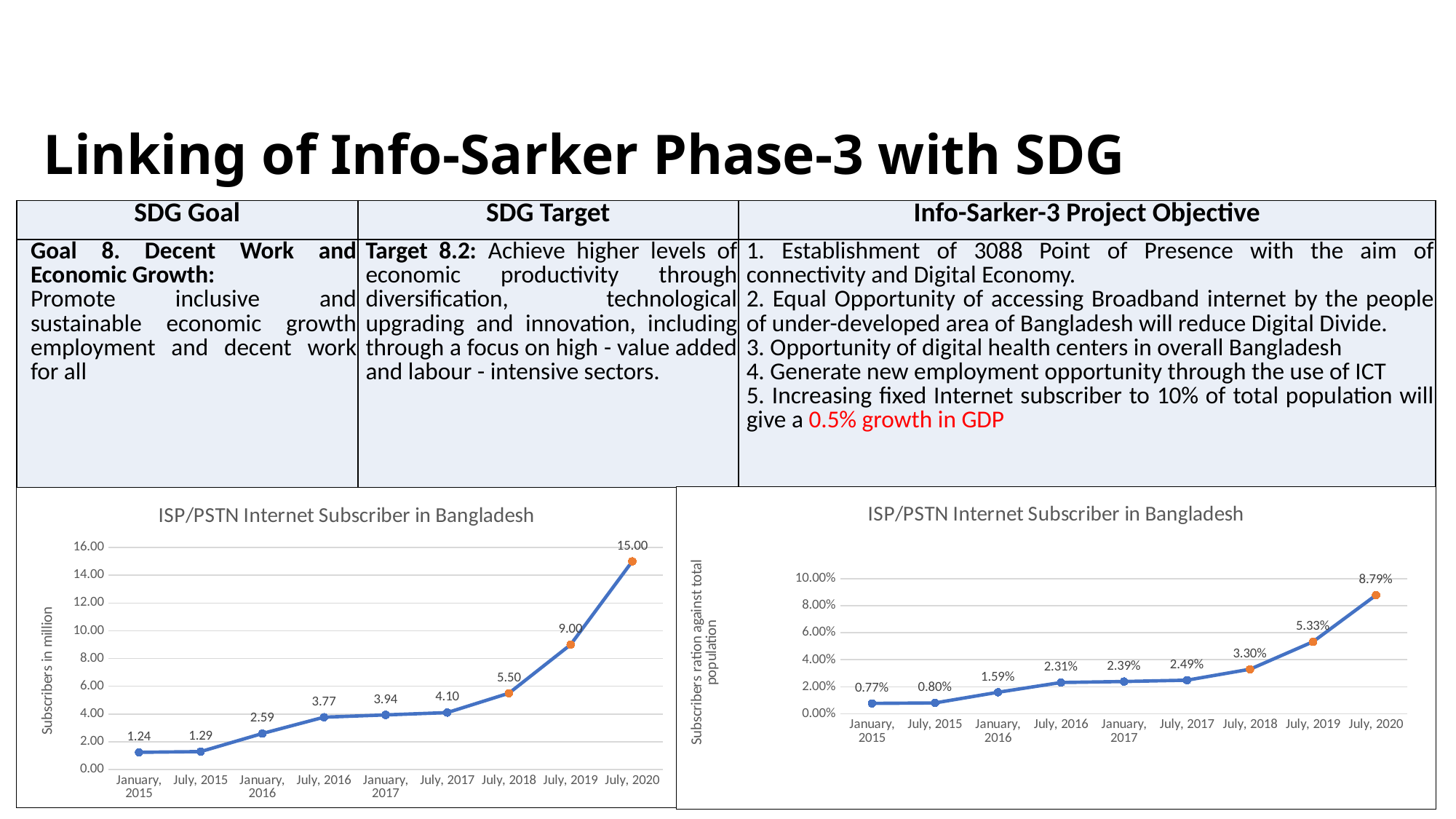
In the right chart, what is the value for July, 2019? 5.33% In the left chart, which is larger, the value for July, 2016 or the value for July, 2017? July, 2017 In the right chart, which point has the highest value? July, 2020 In the left chart, what is the value for July, 2020? 15.00 In the right chart, what is the value for January, 2015? 0.77% In the left chart, what is the difference between the values for July, 2020 and July, 2019? 6.00 What is the y-axis label of the left chart? Subscribers in million In the right chart, what is the difference between the values for July, 2018 and July, 2017? 0.81% In the left chart, what is the value for January, 2016? 2.59 What type of chart is the right chart? Line chart How many data points are plotted in the left chart? 9 In the left chart, which point has the lowest value? January, 2015